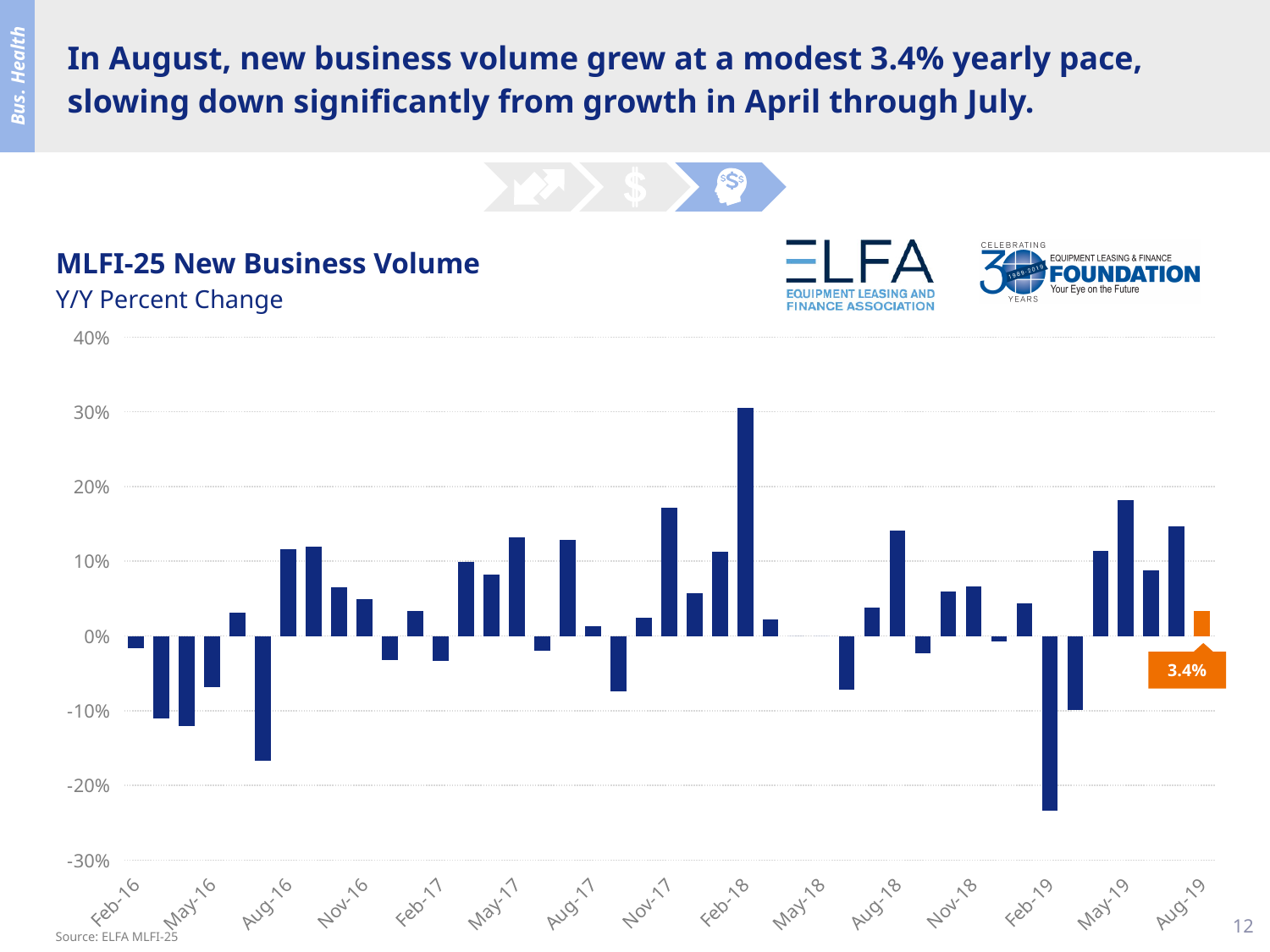
Which month has the highest Y/Y percent change in the chart? Feb-18 Is the value for Feb-19 greater or less than -20%? less What kind of chart is used to show MLFI-25 New Business Volume? Bar chart Which month has the lowest Y/Y percent change in the chart? Feb-19 Which is larger, the value for Aug-18 or the value for Aug-19? Aug-18 What is the Y/Y percent change in MLFI-25 new business volume for Aug-19? 3.4% Is the value for Nov-17 greater or less than 10%? greater What colour is the bar for Aug-19? Orange Is the value for Feb-18 greater or less than 20%? greater Which is larger, the value for Feb-18 or the value for Nov-17? Feb-18 What is the title of the chart? MLFI-25 New Business Volume